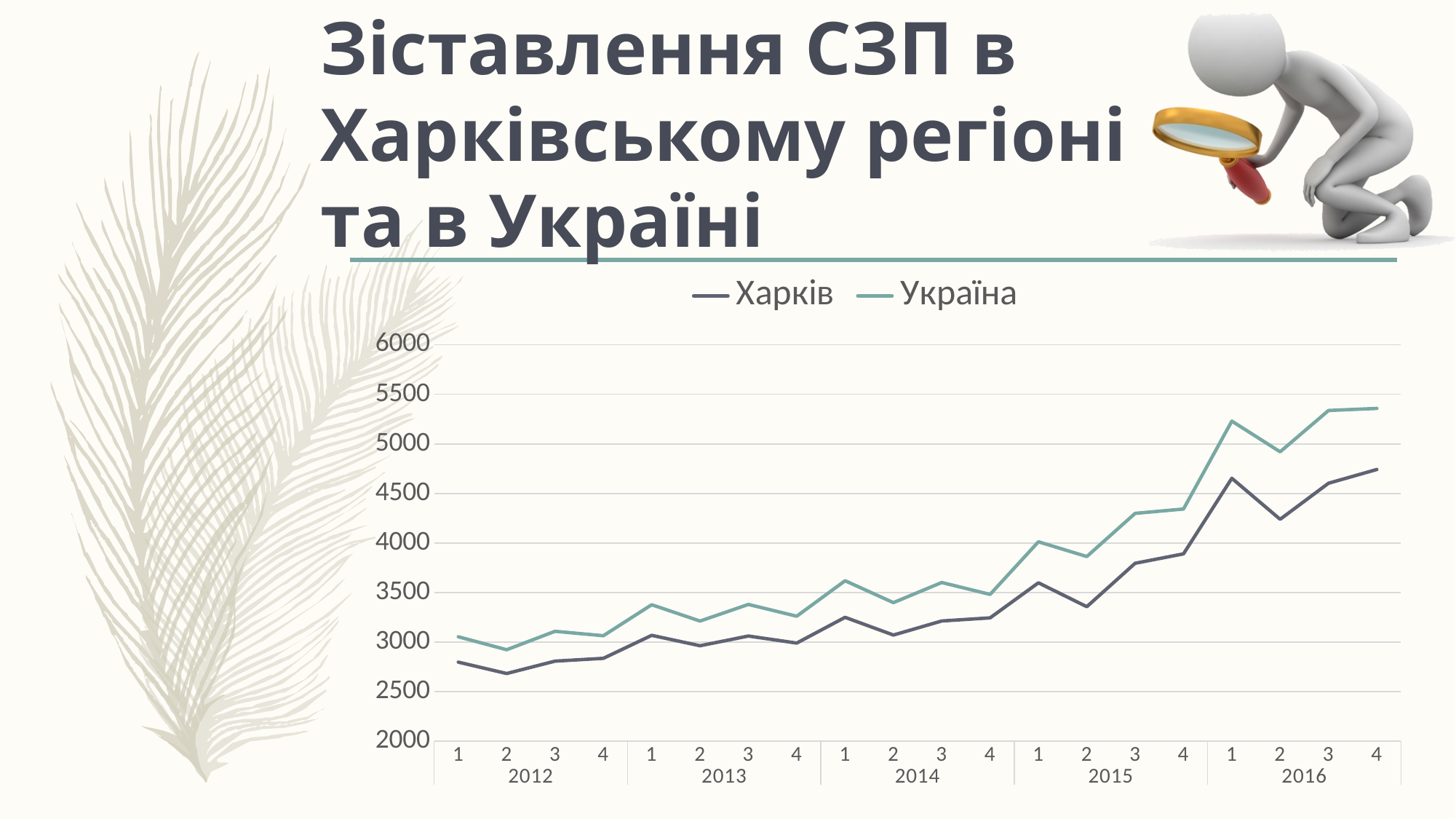
Which years are shown along the x axis? 2012, 2013, 2014, 2015, 2016 Is the value for Харків in quarter 1 of 2016 greater or less than 4500? greater How many series does the legend list? 2 Is the value for Харків in quarter 2 of 2015 greater or less than 3500? less Which series has the higher values across the whole period, Харків or Україна? Україна How many quarterly data points does each line have? 20 Is the value for Харків in quarter 2 of 2012 greater or less than 3000? less In which quarter and year is the Харків line at its lowest? quarter 2 of 2012 What are the two series named in the legend? Харків and Україна What kind of chart is shown on the slide? line chart Overall, do the values for Харків rise or fall from 2012 to 2016? rise